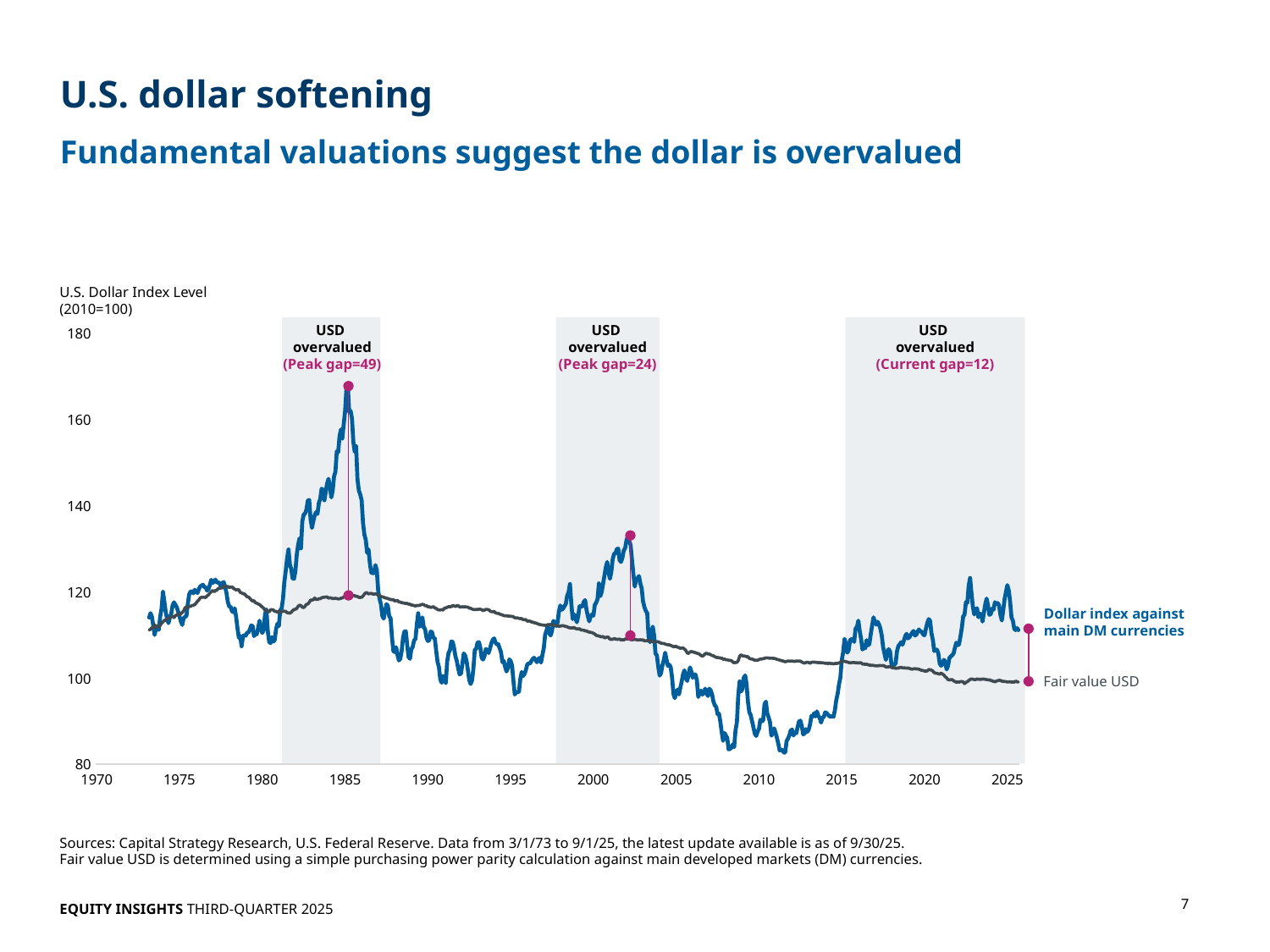
What is the difference between the peak gap of 24 and the current gap of 12? 12 Which of the three labelled gaps is the largest? Peak gap=49 Is the value of the dollar index at its peak around 1985 greater or less than 160? greater How many shaded 'USD overvalued' periods are marked on the chart? 3 What is the peak gap labelled for the first 'USD overvalued' period (around 1985)? 49 Is the value of the dollar index around 2011 greater or less than 100? less What is the peak gap labelled for the 'USD overvalued' period around 2000? 24 What is the current gap labelled for the most recent 'USD overvalued' period? 12 What is the difference between the peak gap of 49 and the peak gap of 24? 25 What kind of chart is shown on the slide? Line chart How many series are plotted on the chart? 2 At the end of the series in 2025, which is higher: the dollar index against main DM currencies or fair value USD? Dollar index against main DM currencies